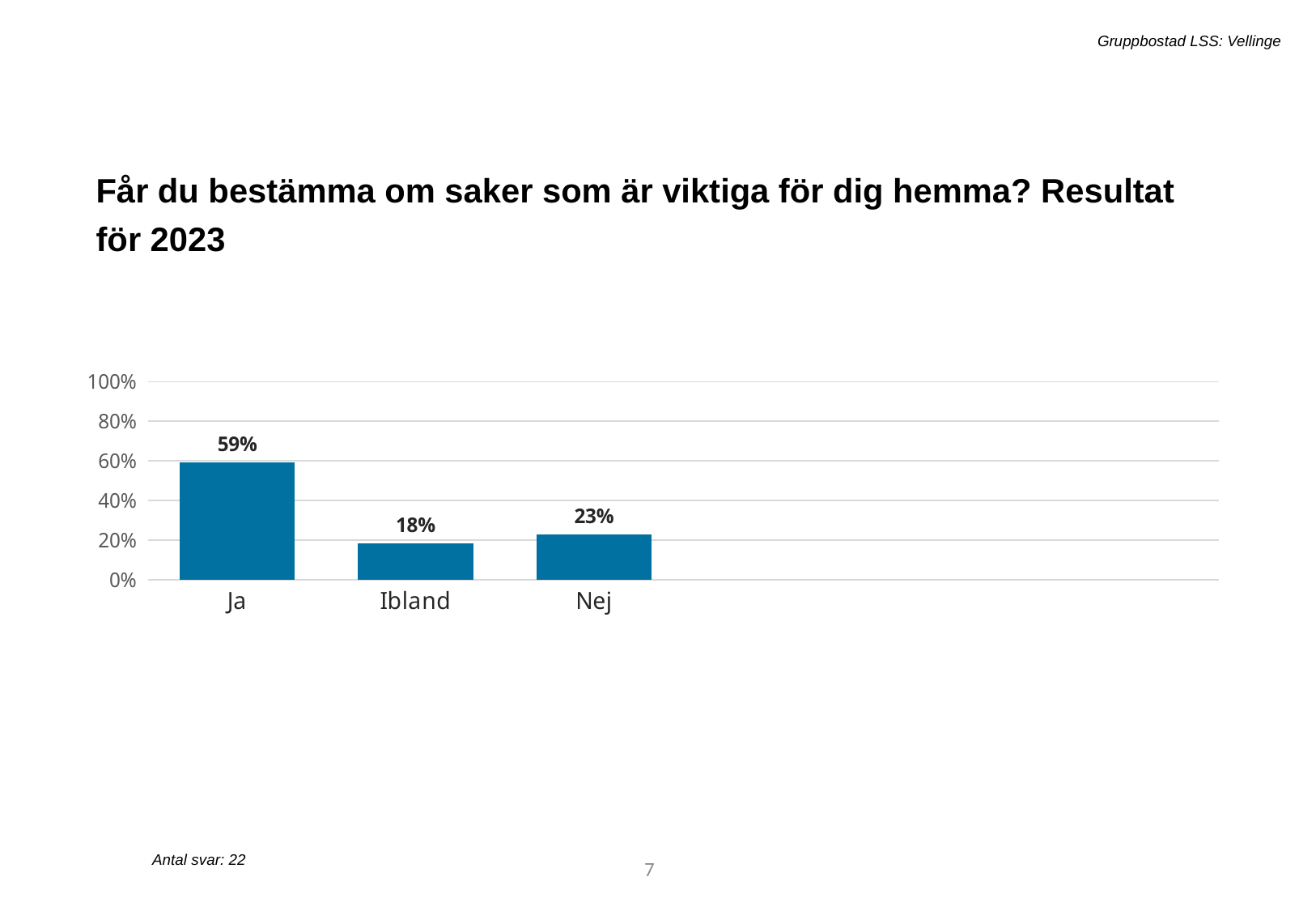
What is the number of responses (Antal svar) stated on the slide? 22 What is the difference between the values for Nej and Ibland? 5% What is the value for Nej? 23% What is the value for Ja? 59% Which category has the highest value? Ja What kind of chart is shown on the slide? Bar chart Which is larger, the value for Ibland or the value for Nej? Nej Which category has the lowest value? Ibland How many categories are shown on the x axis? 3 Is the value for Ja greater or less than 40%? greater What is the value for Ibland? 18% What is the difference between the values for Ja and Nej? 36%